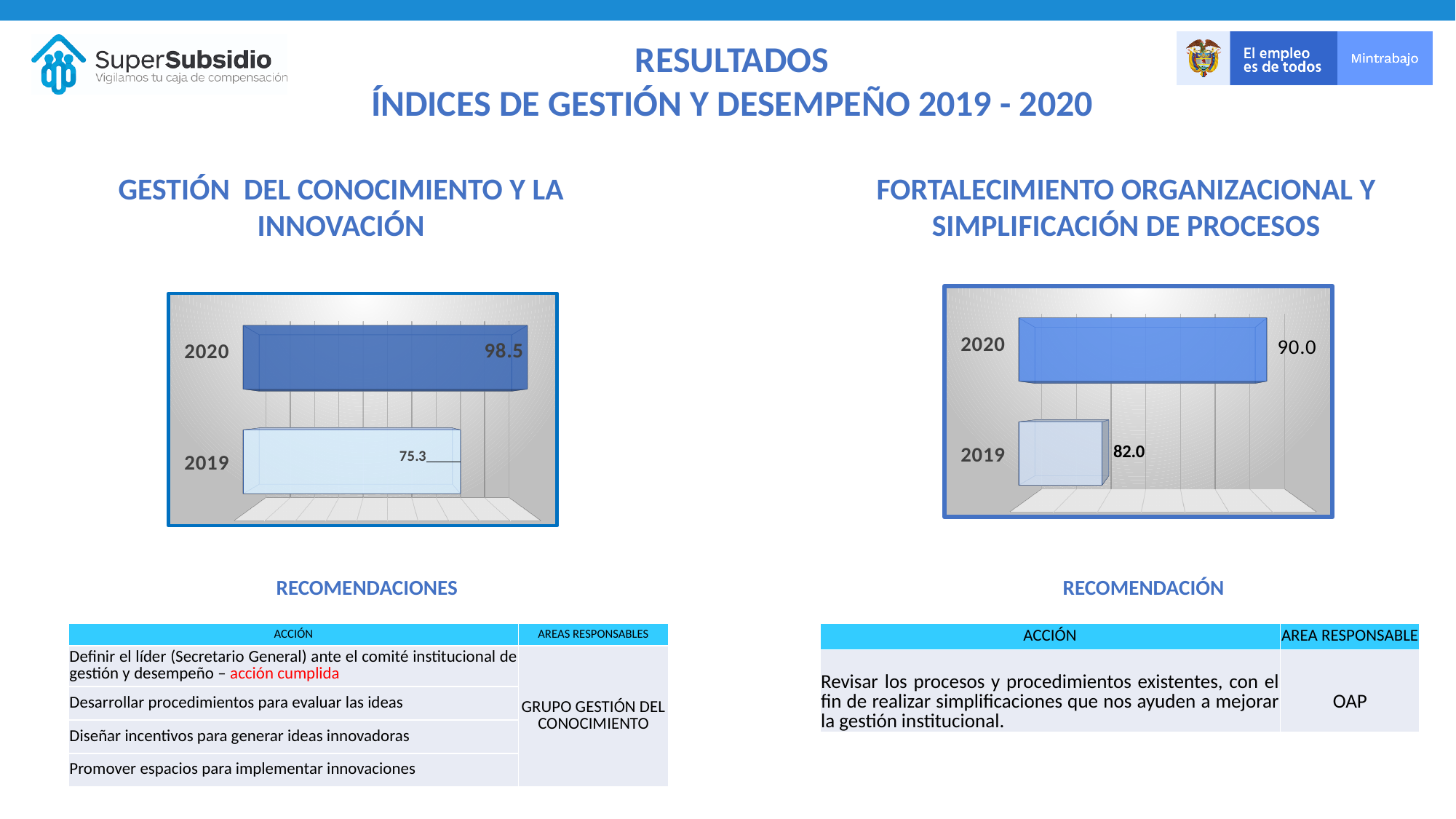
How many categories (years) are shown in the 'Fortalecimiento Organizacional y Simplificación de Procesos' chart? 2 In the 'Fortalecimiento Organizacional y Simplificación de Procesos' chart, what is the difference between the 2020 and 2019 values? 8.0 In the 'Gestión del Conocimiento y la Innovación' chart, what is the value for 2020? 98.5 In the 'Fortalecimiento Organizacional y Simplificación de Procesos' chart, what is the value for 2019? 82.0 Is the 2020 value in the 'Gestión del Conocimiento y la Innovación' chart larger than the 2020 value in the 'Fortalecimiento Organizacional y Simplificación de Procesos' chart? Yes In the 'Gestión del Conocimiento y la Innovación' chart, what is the difference between the 2020 and 2019 values? 23.2 In the 'Gestión del Conocimiento y la Innovación' chart, what is the value for 2019? 75.3 In the 'Fortalecimiento Organizacional y Simplificación de Procesos' chart, which year has the lower value? 2019 What kind of chart is the 'Gestión del Conocimiento y la Innovación' chart? Bar chart In the 'Gestión del Conocimiento y la Innovación' chart, which year has the higher value? 2020 In the 'Fortalecimiento Organizacional y Simplificación de Procesos' chart, what is the value for 2020? 90.0 In the 'Gestión del Conocimiento y la Innovación' chart, did the value rise or fall from 2019 to 2020? Rise